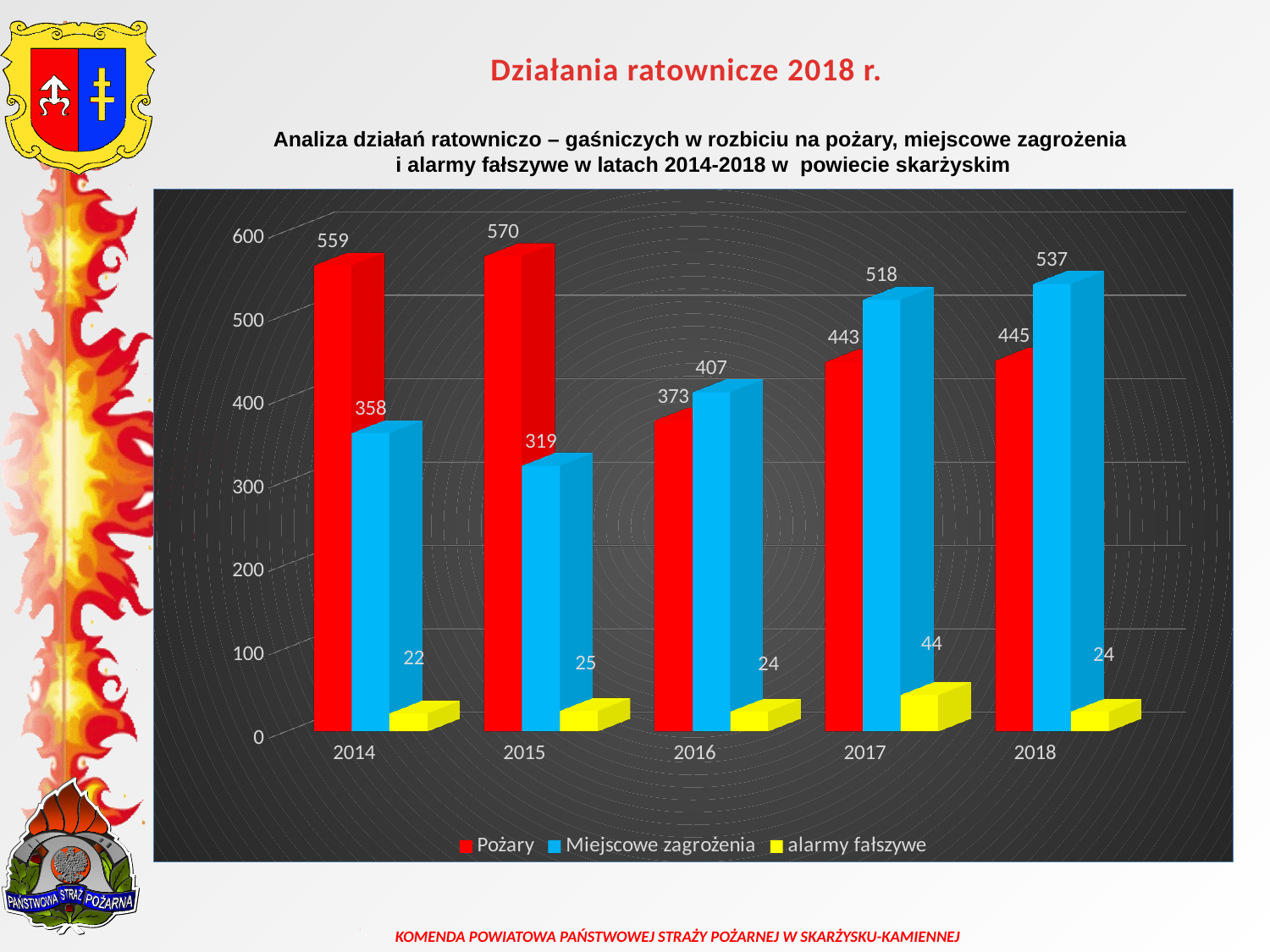
In which year is the value for Miejscowe zagrożenia the lowest? 2015 What is the difference between Pożary and Miejscowe zagrożenia in 2014? 201 In which year is the value for Pożary the highest? 2015 What kind of chart is shown on the slide? bar chart How many years are shown on the x axis? 5 Which is larger in 2016: Pożary or Miejscowe zagrożenia? Miejscowe zagrożenia What is the value for alarmy fałszywe in 2017? 44 Which colour represents alarmy fałszywe in the chart? yellow What is the value for Pożary in 2015? 570 Does the value for Miejscowe zagrożenia rise or fall from 2015 to 2018? rise How many series does the legend list? 3 What is the value for Miejscowe zagrożenia in 2018? 537